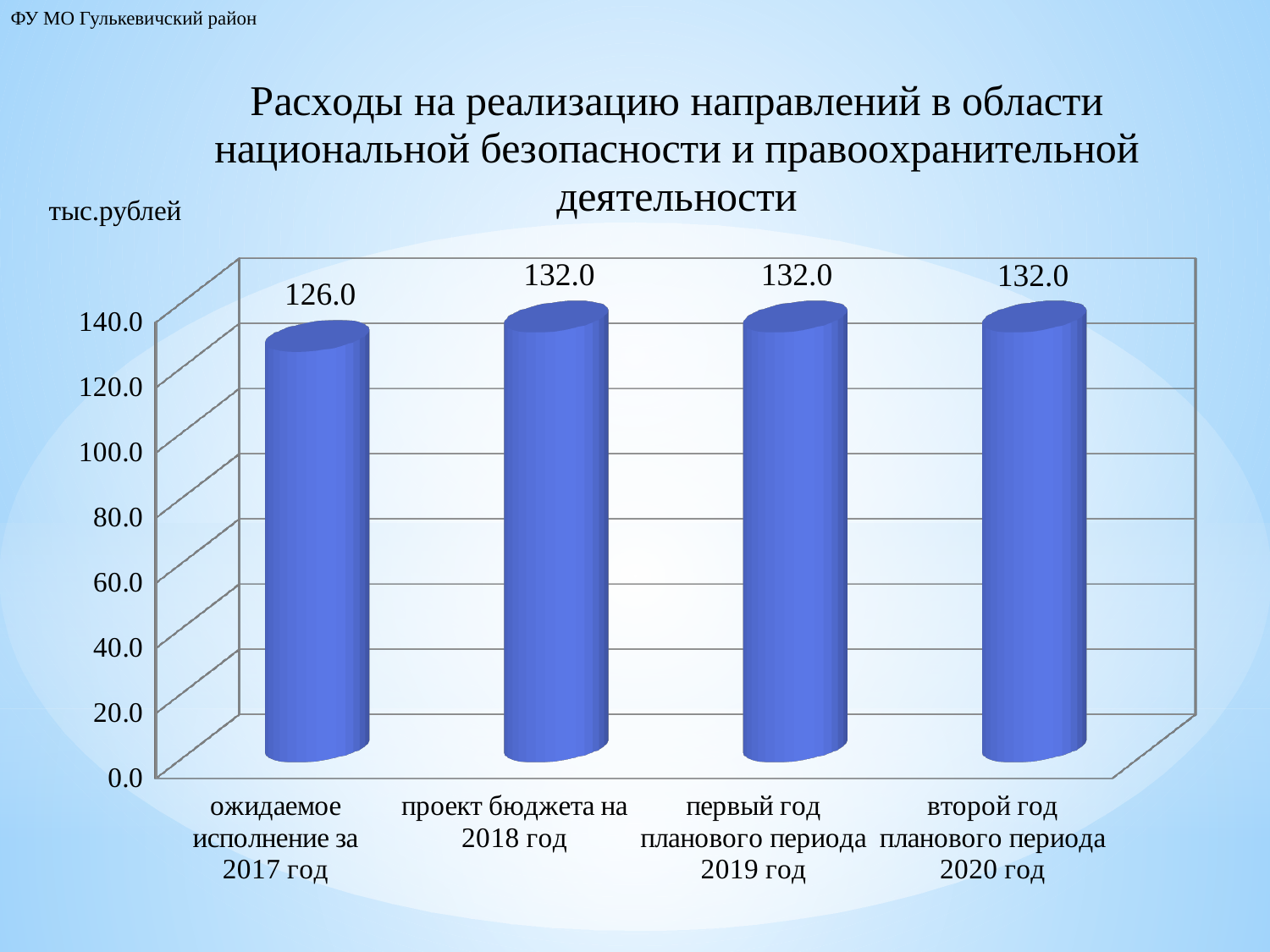
What kind of chart is shown on the slide? bar chart Which category has the lowest value? ожидаемое исполнение за 2017 год What is the value for 'первый год планового периода 2019 год'? 132.0 What is the difference between the value for 2018 (проект бюджета) and the value for 2017 (ожидаемое исполнение)? 6.0 What is the value for 'второй год планового периода 2020 год'? 132.0 What unit is indicated for the values on the chart? тыс.рублей What is the value for 'проект бюджета на 2018 год'? 132.0 Does the value rise or fall from 2017 (ожидаемое исполнение) to 2018 (проект бюджета)? rise Which is larger: the value for 'ожидаемое исполнение за 2017 год' or the value for 'проект бюджета на 2018 год'? проект бюджета на 2018 год How many categories are shown on the x axis? 4 Is the value for 'ожидаемое исполнение за 2017 год' greater or less than 140? less What is the value for 'ожидаемое исполнение за 2017 год'? 126.0